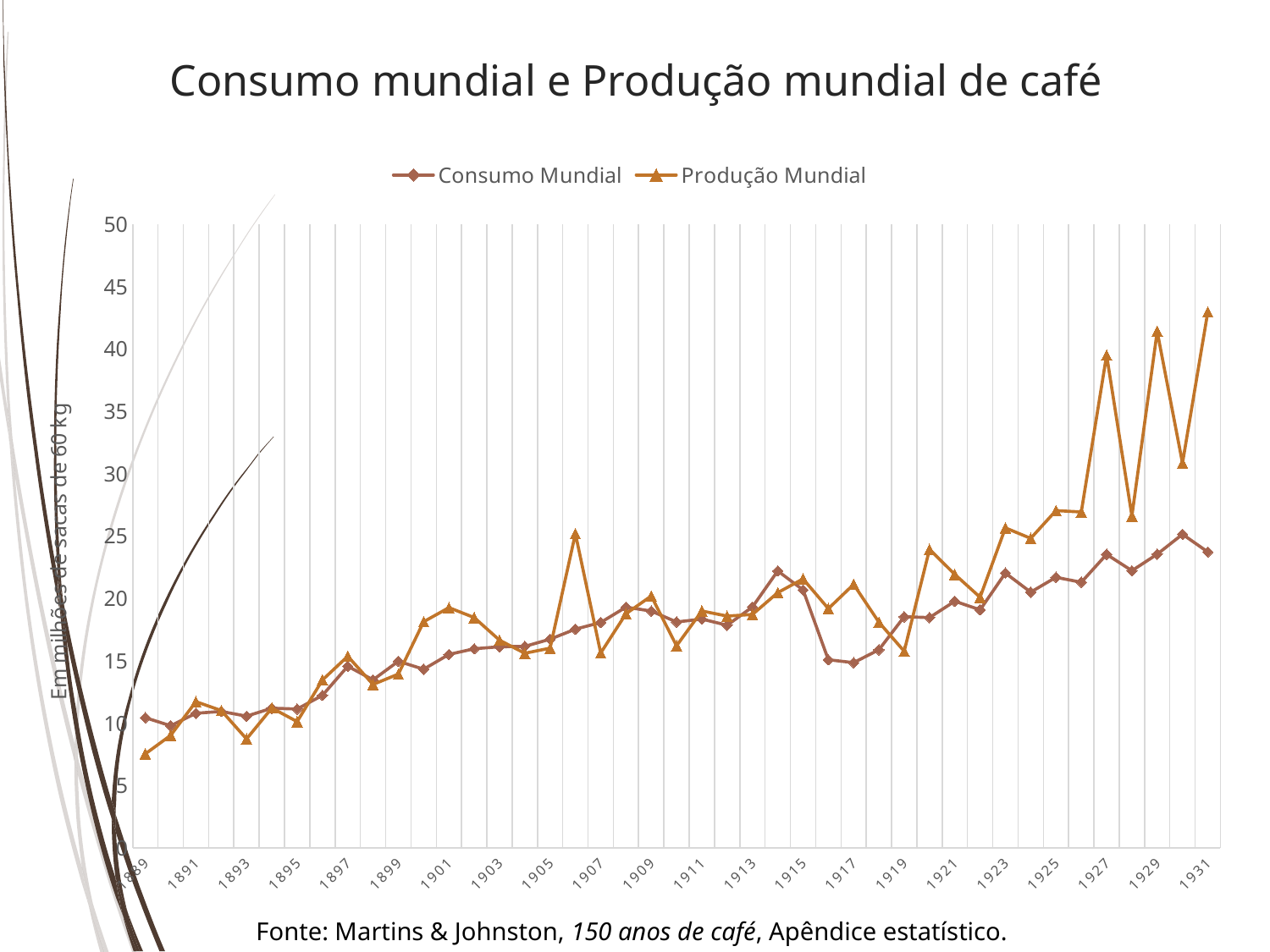
How many series does the legend list? 2 In which year does Produção Mundial reach its highest value? 1931 What kind of chart is shown on the slide? line chart Does Consumo Mundial generally rise or fall from 1889 to 1931? rise Is the value for Produção Mundial in 1889 greater or less than 10? less In which year is Produção Mundial at its lowest? 1889 What is the label of the vertical axis? Em milhões de sacas de 60 kg In 1931, which series has the larger value, Consumo Mundial or Produção Mundial? Produção Mundial Is the value for Produção Mundial in 1931 greater or less than 40? greater Is the value for Consumo Mundial in 1931 greater or less than 25? less What is the title of the chart? Consumo mundial e Produção mundial de café In which year does Consumo Mundial reach its highest value? 1930